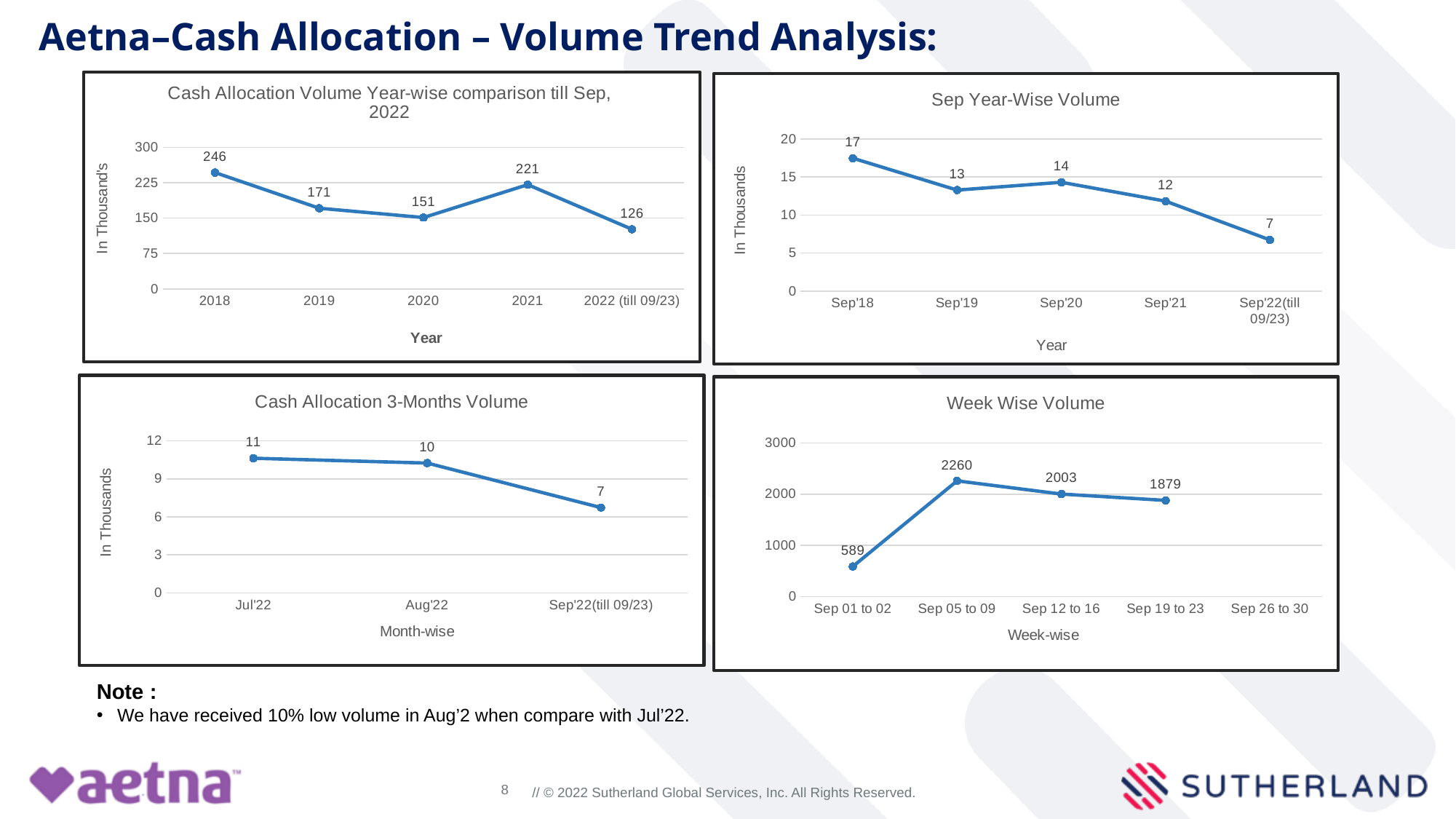
In the 'Sep Year-Wise Volume' chart, how many data points are plotted? 5 What kind of chart is the 'Week Wise Volume' chart? line chart In the 'Week Wise Volume' chart, is the value for Sep 01 to 02 greater or less than 1000? less In the 'Sep Year-Wise Volume' chart, what is the value for Sep'20? 14 In the 'Cash Allocation 3-Months Volume' chart, do the values rise or fall from Jul'22 to Sep'22(till 09/23)? fall In the 'Cash Allocation Volume Year-wise comparison till Sep, 2022' chart, what is the difference between the values for 2021 and 2020? 70 In the 'Cash Allocation 3-Months Volume' chart, what is the value for Aug'22? 10 In the 'Sep Year-Wise Volume' chart, which category has the highest value? Sep'18 In the 'Week Wise Volume' chart, what is the value for Sep 05 to 09? 2260 In the 'Cash Allocation Volume Year-wise comparison till Sep, 2022' chart, which year has the lowest value? 2022 (till 09/23) In the 'Week Wise Volume' chart, which is larger, the value for Sep 12 to 16 or Sep 19 to 23? Sep 12 to 16 In the 'Cash Allocation Volume Year-wise comparison till Sep, 2022' chart, what is the value for 2018? 246